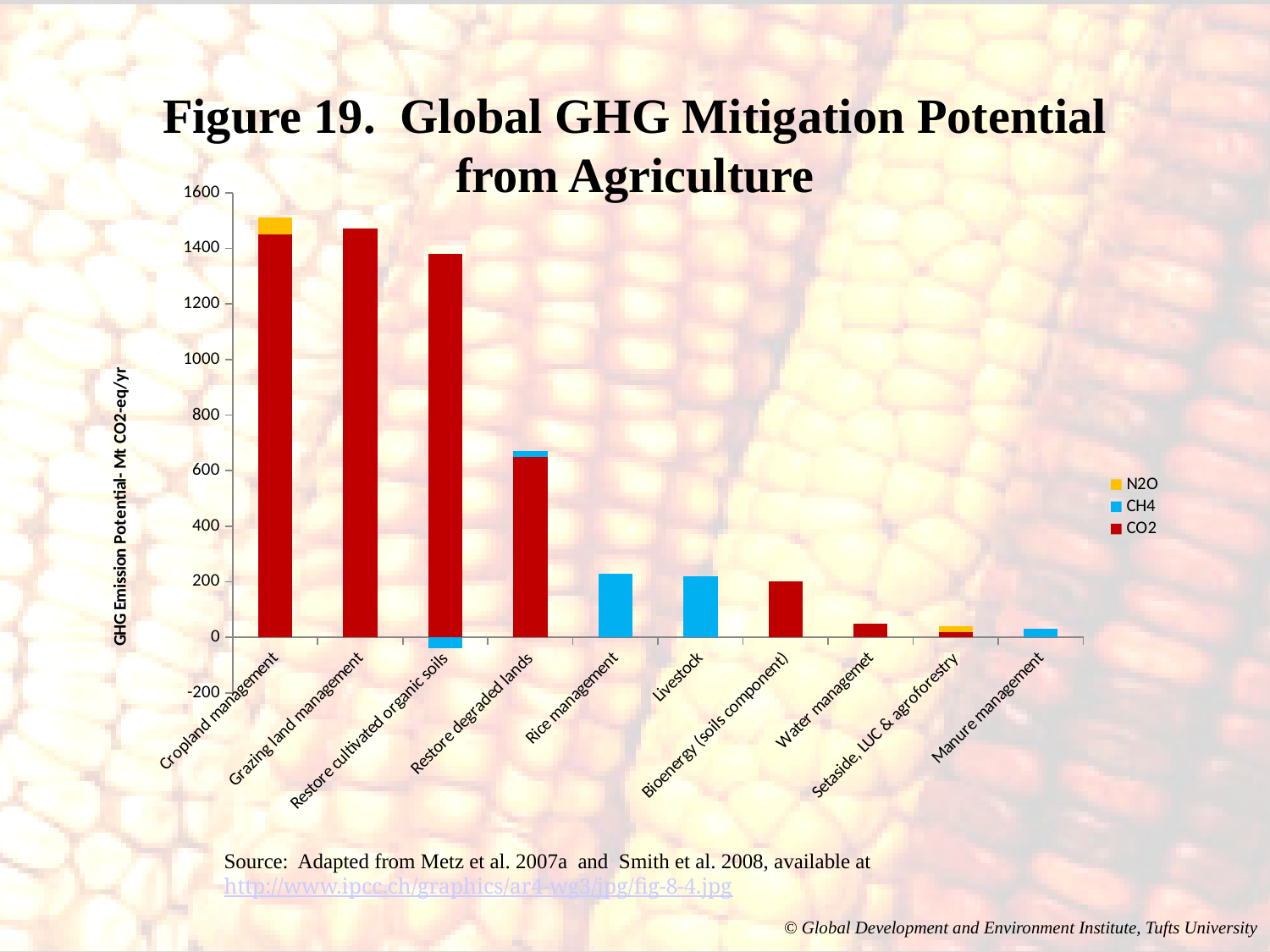
Is the value for Rice management greater or less than 400? less Is the value for Water management greater or less than 200? less Which is larger, the value for Cropland management or the value for Restore degraded lands? Cropland management How many series does the legend list? 3 Do the bar heights generally rise or fall moving from left to right along the x axis? fall Is the value for Restore degraded lands greater or less than 600? greater Which series are listed in the legend? N2O, CH4, CO2 What kind of chart is shown on the slide? bar chart How many categories are shown on the x axis of the chart? 10 What is the label on the vertical axis? GHG Emission Potential- Mt CO2-eq/yr